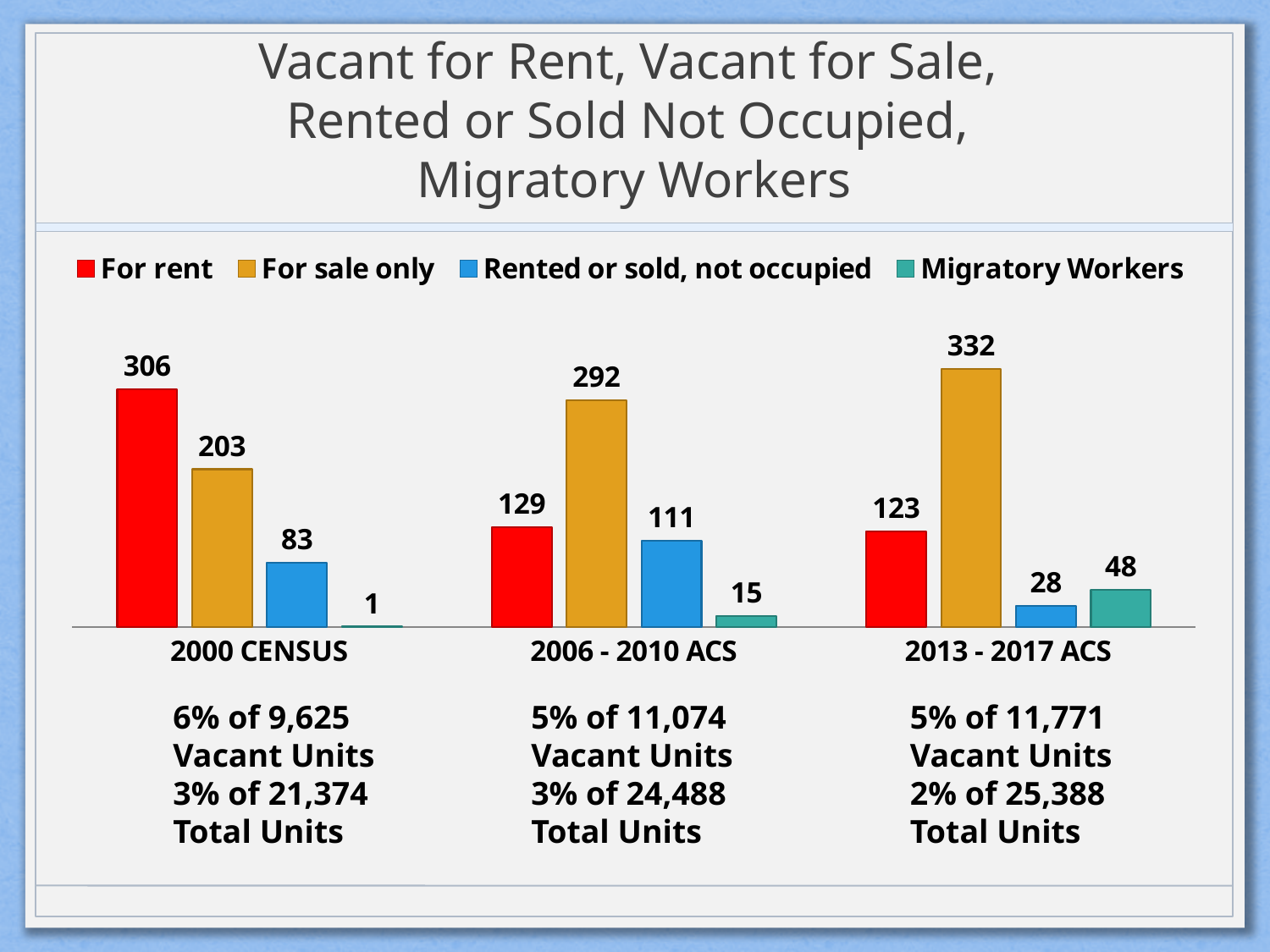
What is the value for 'For sale only' in the 2013 - 2017 ACS group? 332 How many category groups are shown on the x axis? 3 What kind of chart is shown on the slide? Bar chart Does the 'For rent' value rise or fall from 2000 CENSUS to 2013 - 2017 ACS? Fall What is the value for 'Rented or sold, not occupied' in the 2013 - 2017 ACS group? 28 Which series has the lowest value in the 2013 - 2017 ACS group? Rented or sold, not occupied What is the value for 'Migratory Workers' in the 2006 - 2010 ACS group? 15 What is the value for 'For rent' in the 2000 CENSUS group? 306 Which is larger: 'For rent' in 2006 - 2010 ACS or 'Rented or sold, not occupied' in 2006 - 2010 ACS? For rent in 2006 - 2010 ACS What is the difference between the 'For sale only' values for 2013 - 2017 ACS and 2006 - 2010 ACS? 40 How many series does the legend list? 4 Which series has the highest value in the 2000 CENSUS group? For rent